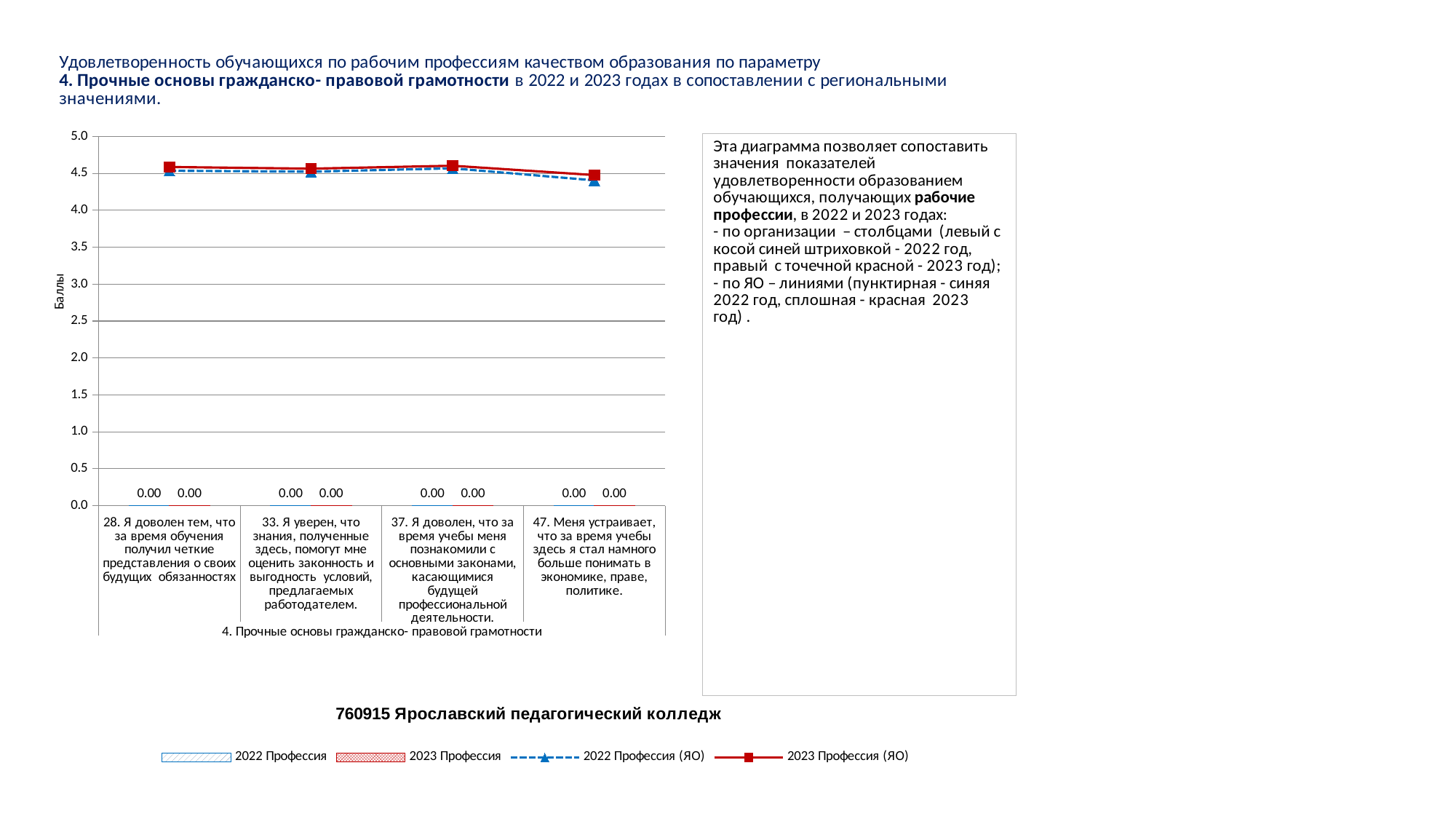
For which question does the 2022 Профессия (ЯО) line reach its lowest value? 47. Меня устраивает, что за время учебы здесь я стал намного больше понимать в экономике, праве, политике. What is the difference between the 2022 Профессия and 2023 Профессия bars for question 37? 0.00 Is the value of the 2023 Профессия (ЯО) line for question 28 greater or less than 4.0? greater What kind of chart is shown on the slide? Combined bar and line chart How many series does the chart legend list? 4 What is the value of the 2023 Профессия bar for question 47 ("Меня устраивает, что за время учебы здесь я стал намного больше понимать в экономике, праве, политике")? 0.00 What is the title of the vertical axis of the chart? Баллы What is the value of the 2022 Профессия bar for question 28 ("Я доволен тем, что за время обучения получил четкие представления о своих будущих обязанностях")? 0.00 What is the value of the 2023 Профессия bar for question 33? 0.00 How many question categories are shown on the x axis of the chart? 4 Is the value of the 2022 Профессия (ЯО) line for question 47 greater or less than 4.0? greater Is the value of the 2023 Профессия (ЯО) line for question 37 greater or less than 5.0? less